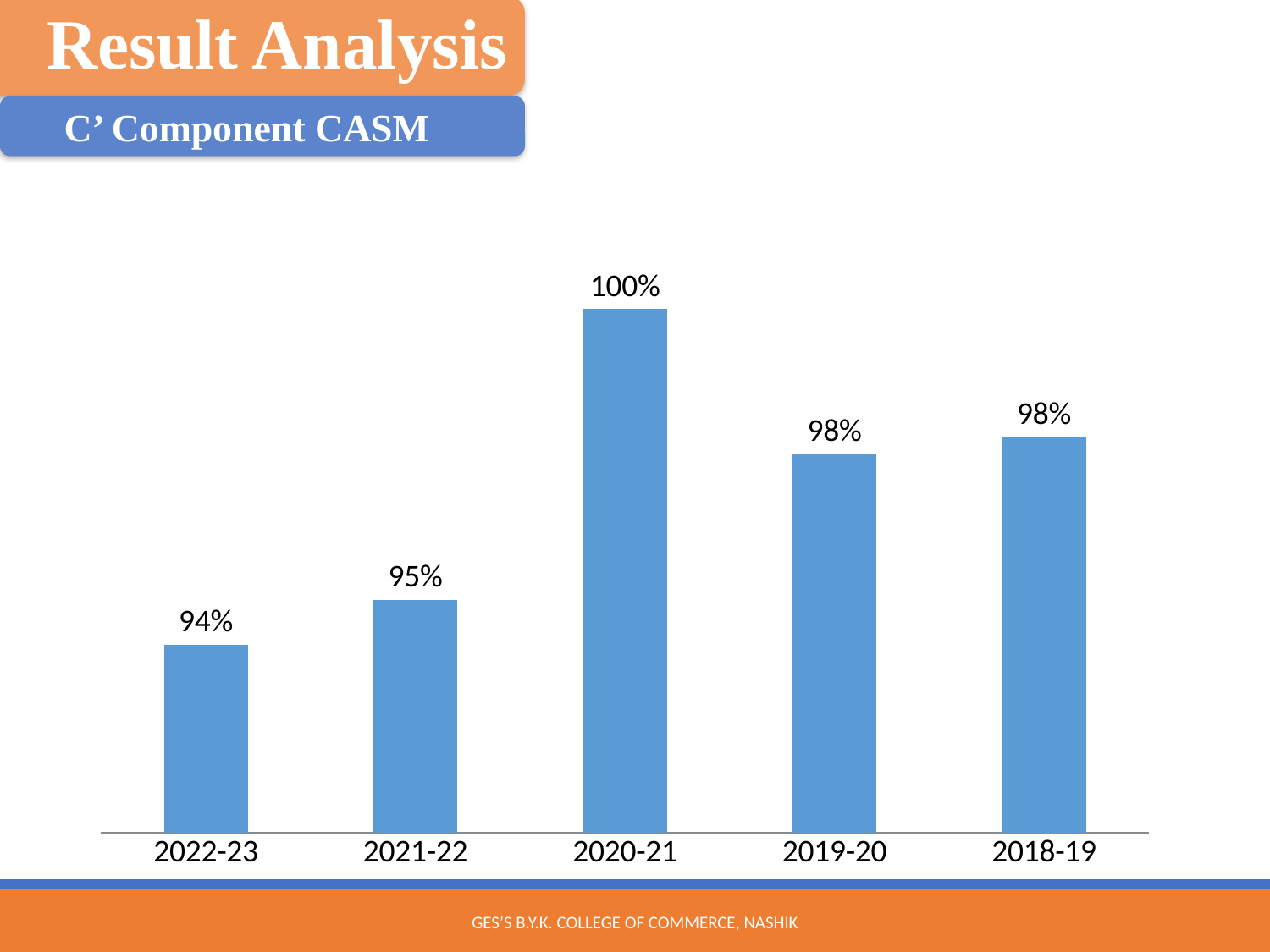
What kind of chart is shown on the slide? Bar chart Which year has the lowest value? 2022-23 What is the value for 2022-23? 94% Which year has the highest value? 2020-21 How many years are shown on the chart? 5 What is the difference between the values for 2019-20 and 2021-22? 3% Which is larger, the value for 2021-22 or the value for 2018-19? 2018-19 What is the value for 2019-20? 98% What is the value for 2020-21? 100% What is the subtitle shown above the chart? C’ Component CASM What is the difference between the values for 2020-21 and 2022-23? 6% What is the value for 2021-22? 95%